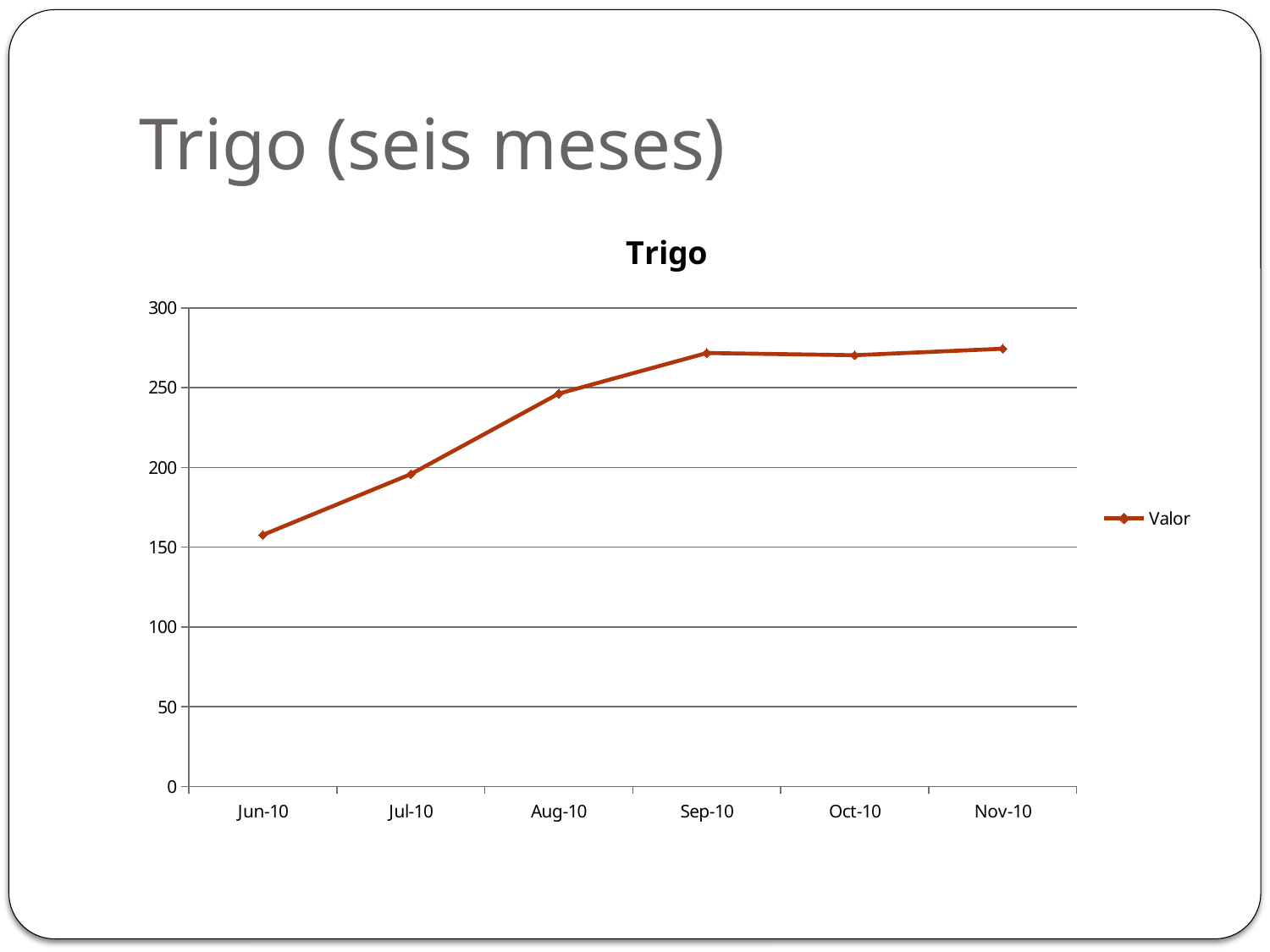
Is the value for Nov-10 greater or less than 300? less Is the value for Sep-10 greater or less than 250? greater What kind of chart is shown on the slide? line chart How many data points are plotted on the line? 6 Which is larger, the value for Jun-10 or the value for Aug-10? Aug-10 Do the values generally rise or fall from Jun-10 to Nov-10? rise What is the title of the chart? Trigo Is the value for Oct-10 greater or less than 250? greater Which month has the lowest value? Jun-10 What series name does the legend list? Valor How many series does the legend list? 1